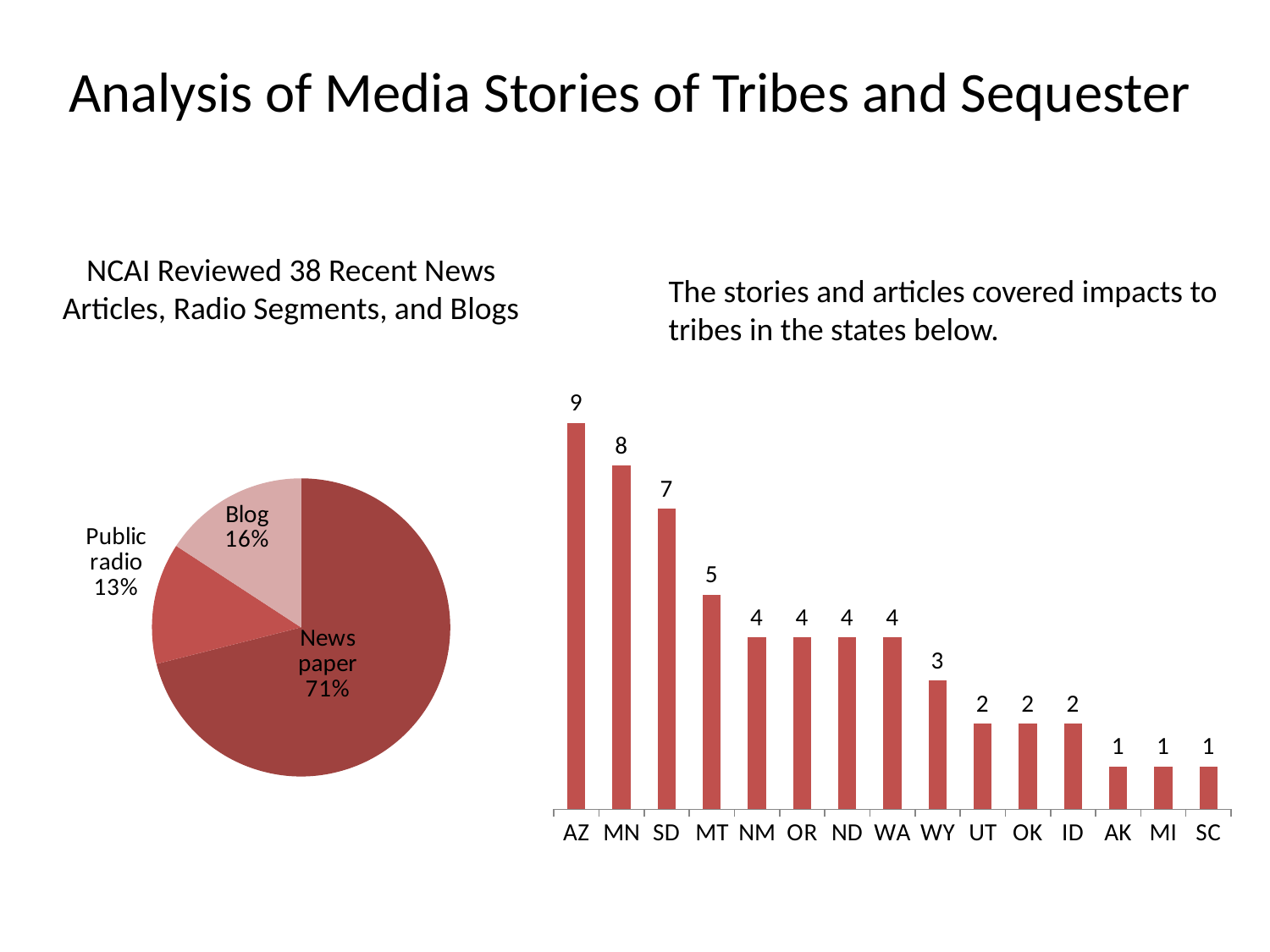
In the bar chart on the right, what is the value for MT? 5 In the bar chart on the right, what is the difference between the values for AZ and SD? 2 In the pie chart on the left, what share does Public radio have? 13% How many states are shown in the bar chart on the right? 15 What is the title of the pie chart on the left? NCAI Reviewed 38 Recent News Articles, Radio Segments, and Blogs In the bar chart on the right, what is the value for AZ? 9 In the pie chart on the left, which category has the smallest share? Public radio In the bar chart on the right, which is larger, the value for MN or the value for WY? MN In the bar chart on the right, which state has the highest value? AZ What kind of chart is on the right side of the slide? bar chart In the bar chart on the right, do the values rise or fall from left to right? fall In the pie chart on the left, what share does Newspaper have? 71%